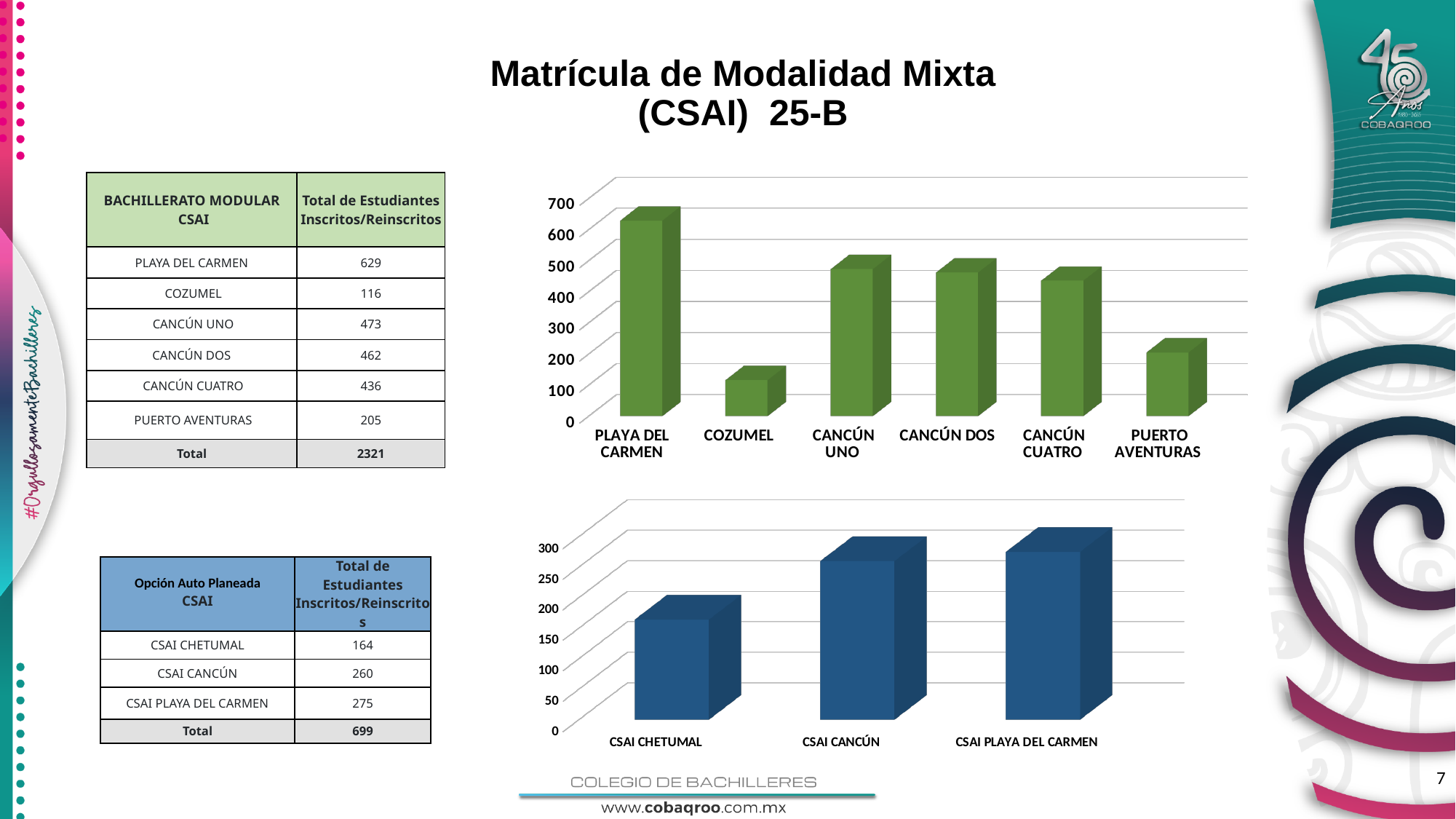
In the top chart, which category has the highest value? PLAYA DEL CARMEN How many categories are plotted in the top chart? 6 In the bottom chart, using the values in the table on the slide, what is the difference between CSAI PLAYA DEL CARMEN and CSAI CHETUMAL? 111 In the bottom chart, which category has the lowest value? CSAI CHETUMAL In the top chart, is the value for PLAYA DEL CARMEN greater or less than 600? greater How many categories are plotted in the bottom chart? 3 In the top chart, which is larger: CANCÚN CUATRO or PUERTO AVENTURAS? CANCÚN CUATRO In the top chart, which category has the lowest value? COZUMEL In the top chart, what is the value for PUERTO AVENTURAS, as given in the table on the slide? 205 In the bottom chart, is the value for CSAI CHETUMAL greater or less than 200? less In the top chart, is the value for COZUMEL greater or less than 200? less What kind of chart is the top chart on the slide? bar chart